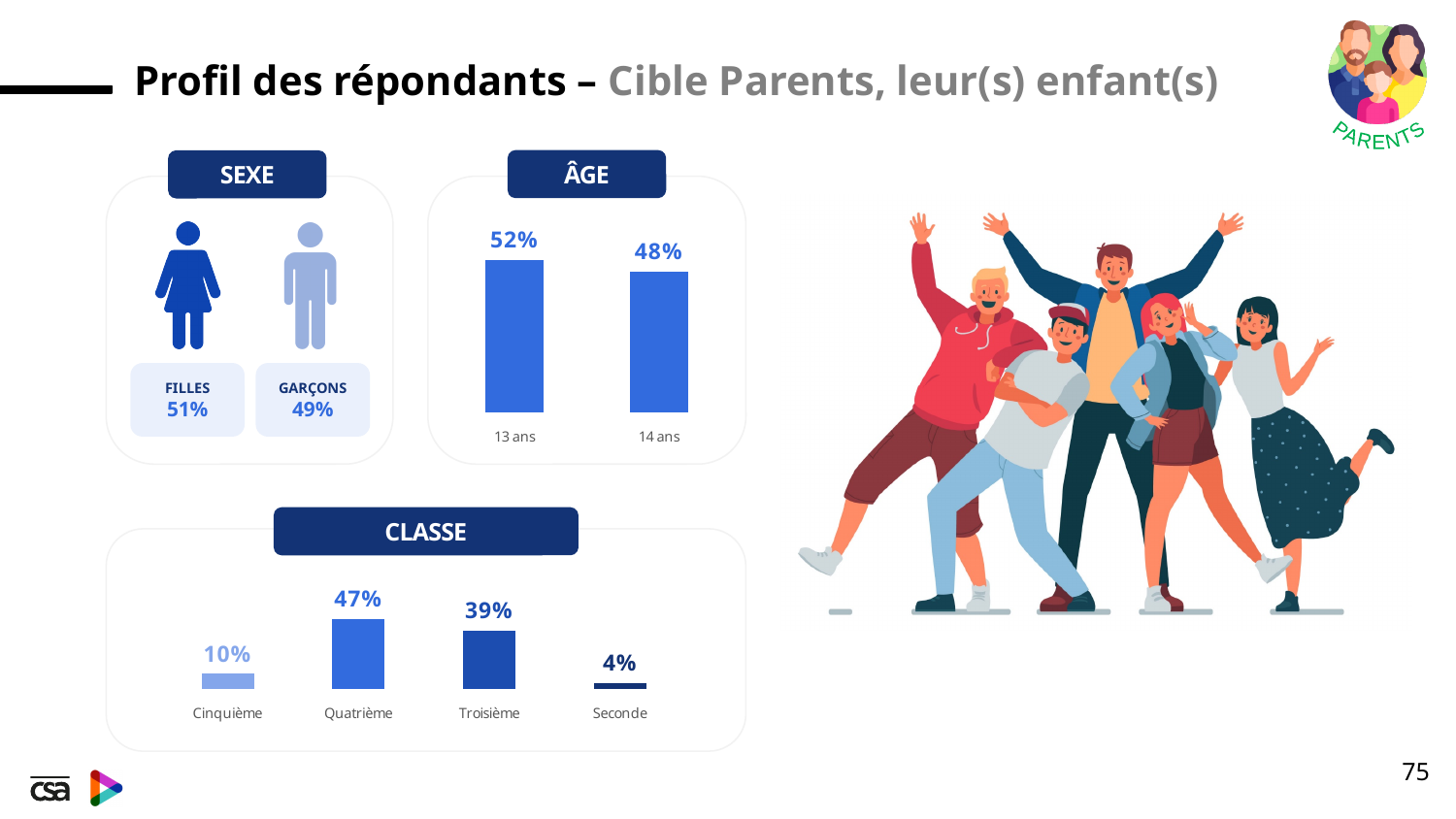
In the CLASSE chart, what is the value for Seconde? 4% In the CLASSE chart, which class has the highest value? Quatrième In the CLASSE chart, what is the difference between the values for Quatrième and Troisième? 8% In the CLASSE chart, how many categories are shown? 4 In the CLASSE chart, what is the value for Quatrième? 47% What kind of chart is the CLASSE chart? Bar chart In the ÂGE chart, which age group has the higher value? 13 ans In the ÂGE chart, how many categories are shown? 2 In the ÂGE chart, what is the value for 13 ans? 52% In the ÂGE chart, what is the difference between the values for 13 ans and 14 ans? 4% In the CLASSE chart, which class has the lowest value? Seconde In the ÂGE chart, what is the value for 14 ans? 48%